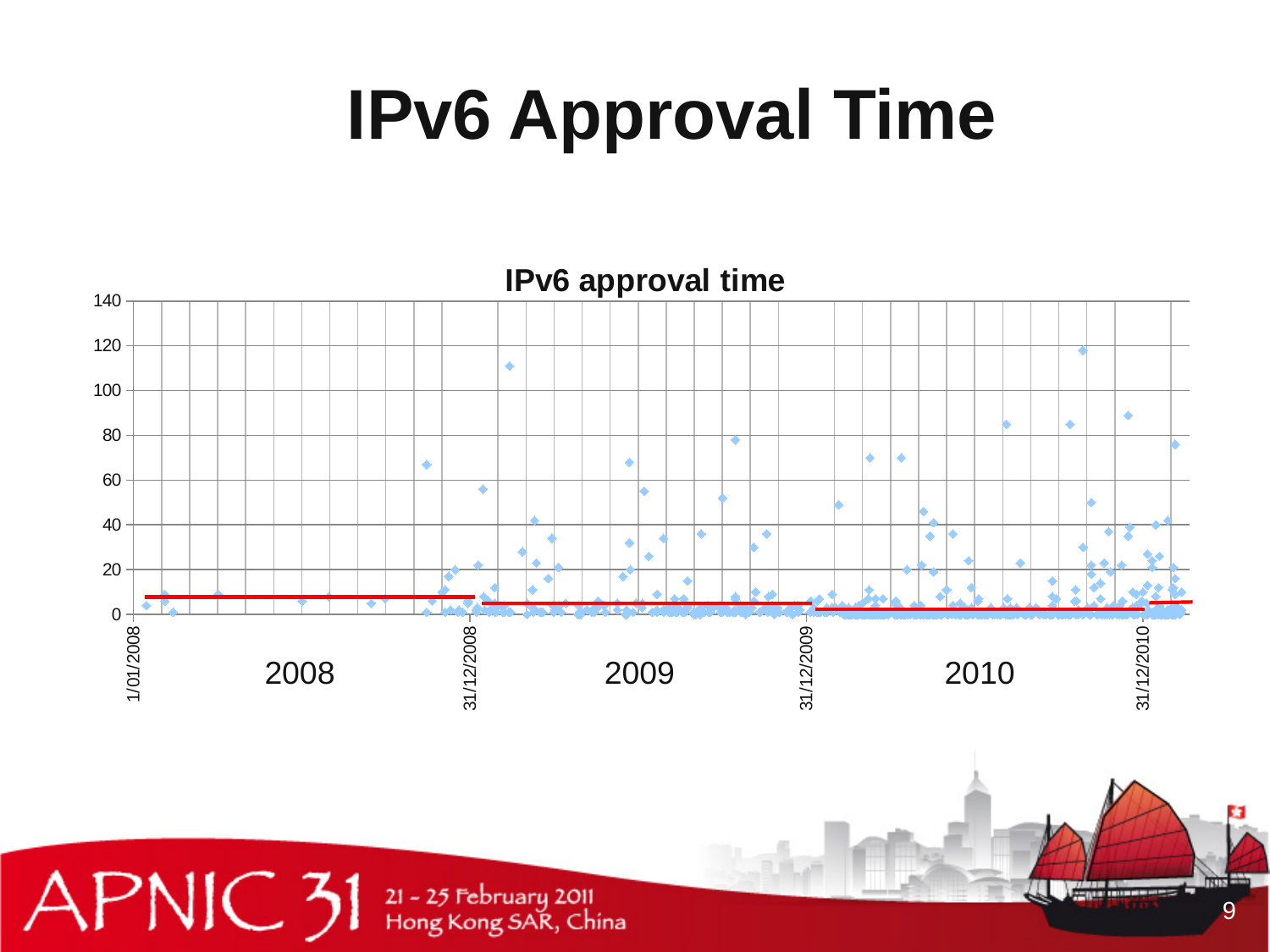
Which year has the highest red average line? 2008 Do the red average lines rise or fall from 2008 to 2010? fall Is the highest data point in 2010 greater or less than 100? greater What is the title of the chart? IPv6 approval time Which year has the lowest red average line? 2010 Is the highest data point in 2008 greater or less than 80? less How many years are labelled along the x axis of the chart? 3 Is the highest data point in 2009 greater or less than 100? greater What is the highest value shown on the chart's vertical axis? 140 Which year has the higher red average line, 2008 or 2010? 2008 What kind of chart is shown on the slide? scatter chart